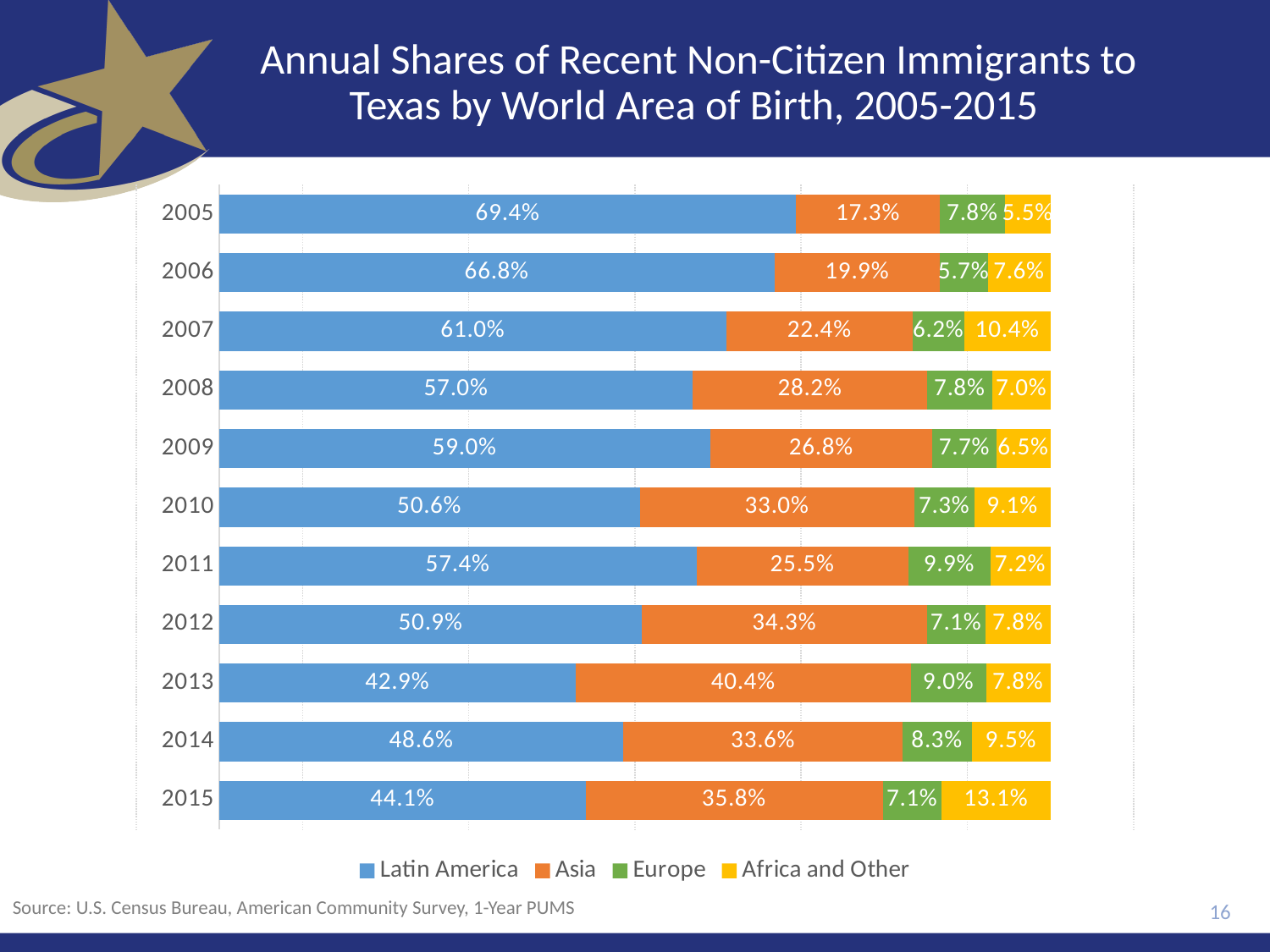
What is the Asia share for 2013? 40.4% What is the difference between the Latin America share in 2005 and in 2015? 25.3 percentage points Which is larger in 2010, the Europe share or the Africa and Other share? Africa and Other How many years are shown on the chart? 11 What is the Africa and Other share for 2015? 13.1% Which year has the lowest Latin America share? 2013 Which year has the highest Asia share? 2013 What is the Latin America share for 2005? 69.4% What kind of chart is shown on the slide? Stacked bar chart What is the Europe share for 2011? 9.9% How many series does the legend list? 4 Which year has the highest Latin America share? 2005